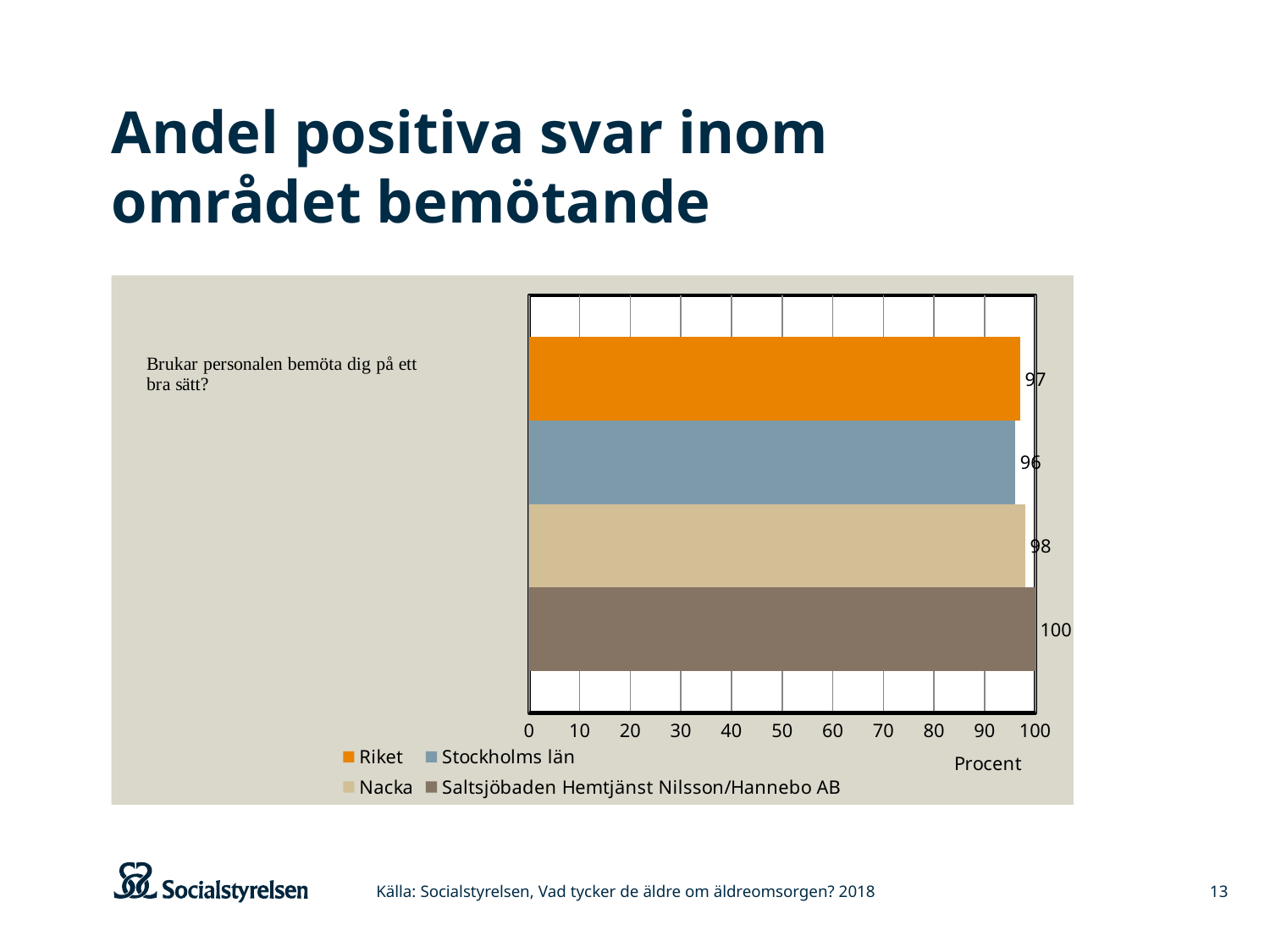
What is the difference between the values for Nacka and Riket? 1 What kind of chart is shown on the slide? Bar chart Which series has the lowest value? Stockholms län How many series does the legend list? 4 Which series has the highest value? Saltsjöbaden Hemtjänst Nilsson/Hannebo AB What is the value for Saltsjöbaden Hemtjänst Nilsson/Hannebo AB? 100 What is the difference between the values for Saltsjöbaden Hemtjänst Nilsson/Hannebo AB and Stockholms län? 4 Which series is shown in orange in the legend? Riket What is the value for Nacka? 98 What is the value for Stockholms län? 96 What is the value for Riket? 97 What is the label of the x axis? Procent